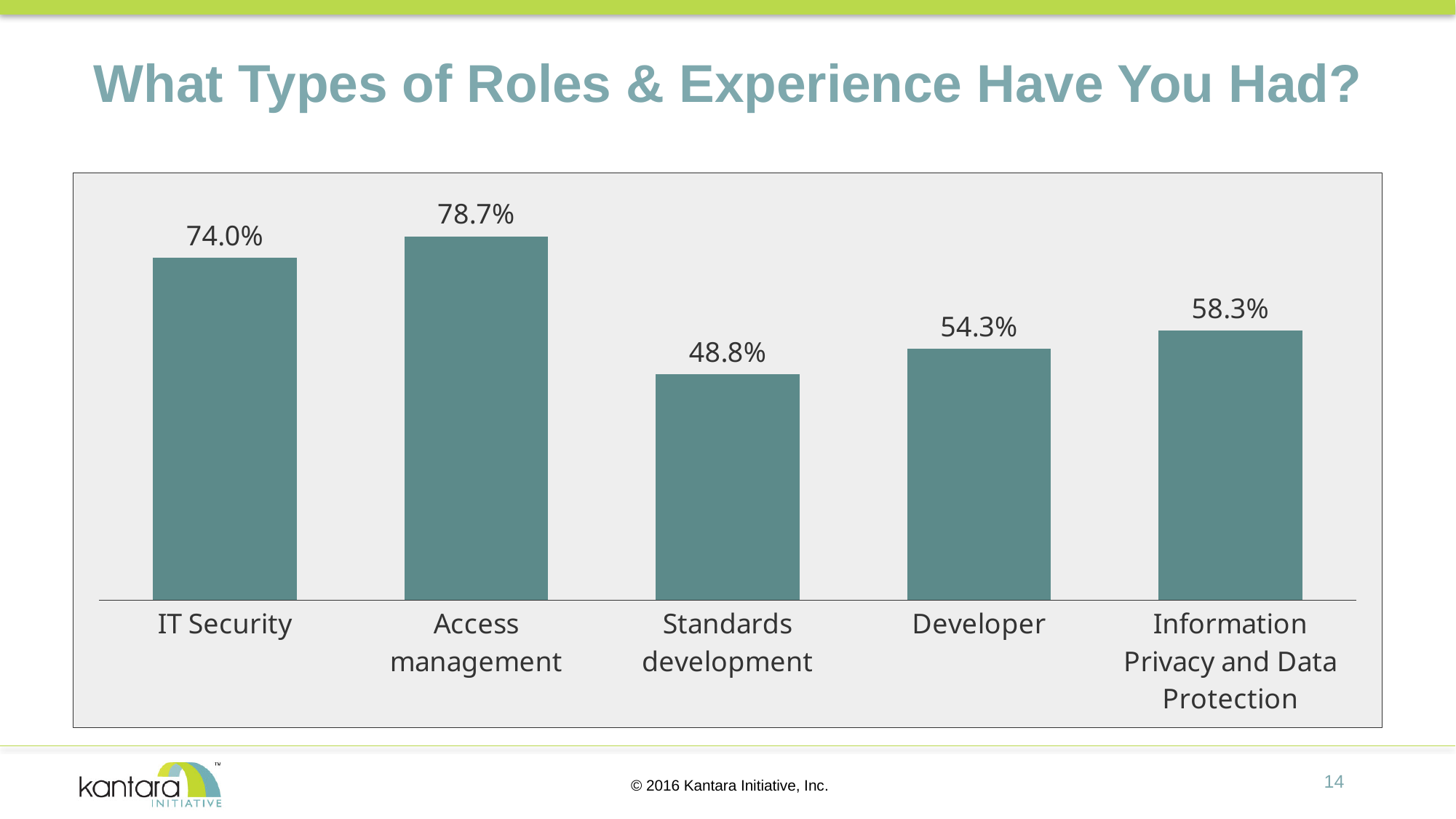
What is the title of the slide? What Types of Roles & Experience Have You Had? What percentage is shown for Developer? 54.3% Which role has the highest percentage? Access management What is the difference between the percentages for Access management and IT Security? 4.7% What percentage is shown for Information Privacy and Data Protection? 58.3% Which role has the lowest percentage? Standards development What percentage is shown for Standards development? 48.8% What type of chart is shown on the slide? Bar chart Which is larger, the percentage for Developer or for Information Privacy and Data Protection? Information Privacy and Data Protection What percentage is shown for Access management? 78.7% How many roles are shown in the chart? 5 What percentage is shown for IT Security? 74.0%